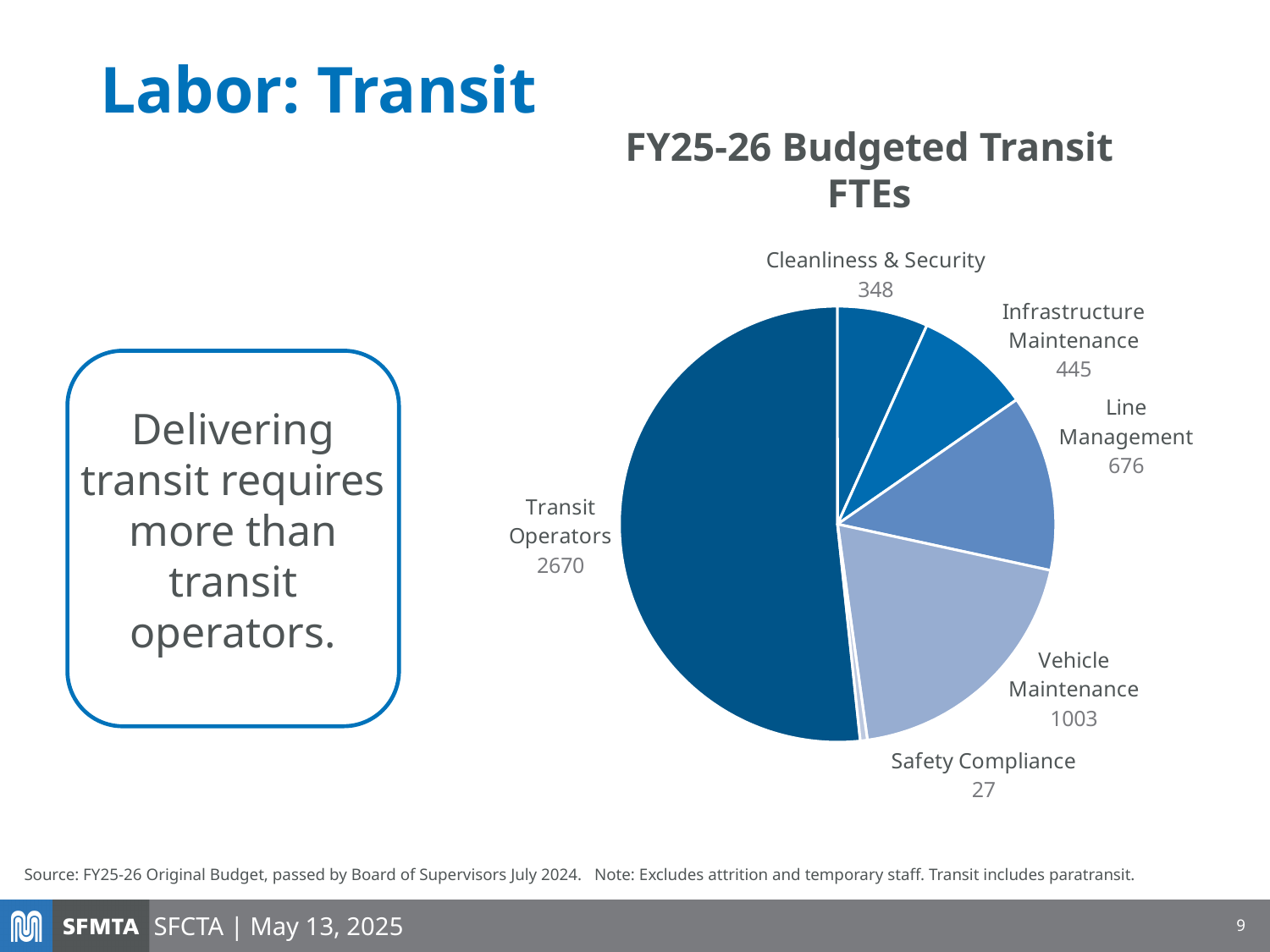
What is the title of the chart? FY25-26 Budgeted Transit FTEs How many FTEs are budgeted for Vehicle Maintenance? 1003 What is the difference in FTEs between Transit Operators and Vehicle Maintenance? 1667 How many categories are shown in the pie chart? 6 How many FTEs are budgeted for Line Management? 676 Which has more FTEs, Infrastructure Maintenance or Cleanliness & Security? Infrastructure Maintenance Which category has the largest number of FTEs? Transit Operators Which category has the smallest number of FTEs? Safety Compliance What kind of chart is shown on the slide? pie chart How many FTEs are budgeted for Transit Operators? 2670 How many FTEs are budgeted for Safety Compliance? 27 What is the difference in FTEs between Line Management and Infrastructure Maintenance? 231